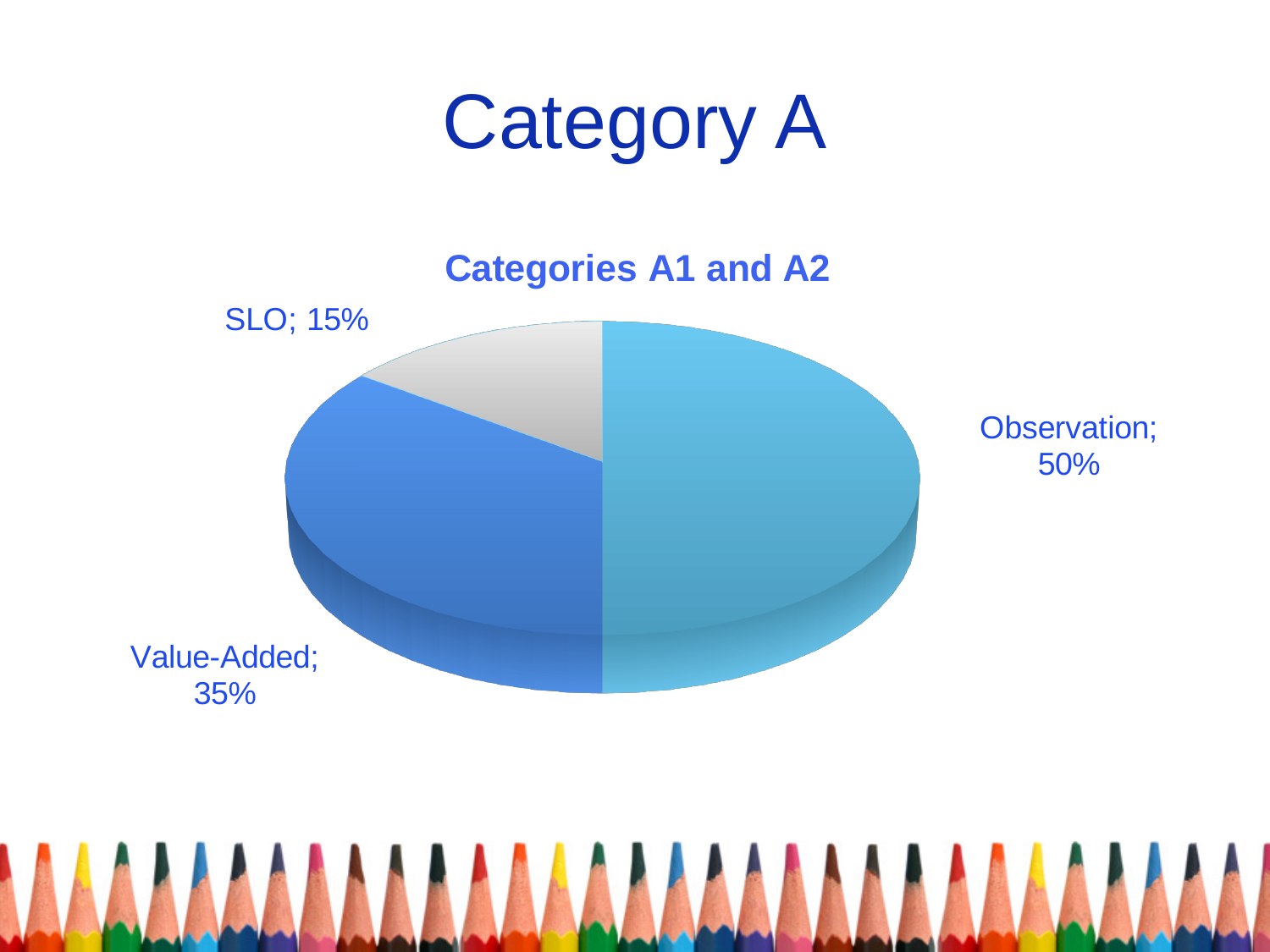
What kind of chart is shown on the slide? Pie chart What is the difference in percentage points between Observation and Value-Added? 15 What percentage of the pie chart is Value-Added? 35% What colour is the SLO slice of the pie chart? Grey What percentage of the pie chart is SLO? 15% Which is larger, the Value-Added slice or the SLO slice? Value-Added Which slice of the pie chart is the smallest? SLO Which slice of the pie chart is the largest? Observation What is the title of the chart? Categories A1 and A2 What is the difference in percentage points between Value-Added and SLO? 20 What percentage of the pie chart is Observation? 50% How many slices does the pie chart have? 3